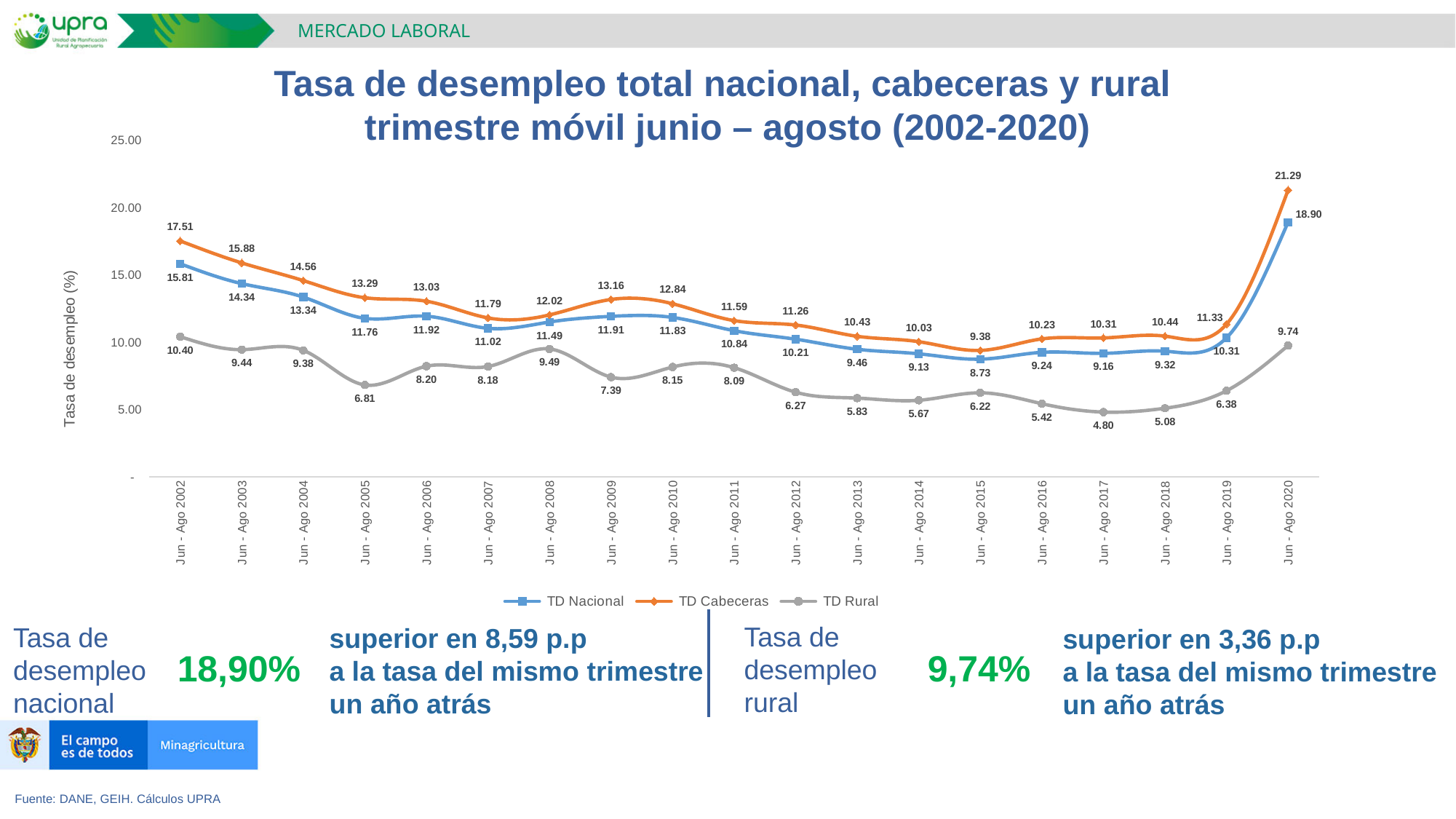
What is the value of TD Cabeceras for Jun - Ago 2020? 21.29 What is the value of TD Nacional for Jun - Ago 2002? 15.81 How many series does the legend list? 3 In which period does TD Nacional reach its lowest value? Jun - Ago 2015 In which period does TD Rural reach its highest value? Jun - Ago 2002 How many periods are shown on the x axis? 19 By how much did TD Rural increase from Jun - Ago 2019 to Jun - Ago 2020? 3.36 Which is larger for TD Rural: Jun - Ago 2008 or Jun - Ago 2009? Jun - Ago 2008 What is the difference between TD Cabeceras and TD Nacional in Jun - Ago 2020? 2.39 What kind of chart is shown on the slide? Line chart In which period does TD Cabeceras reach its lowest value? Jun - Ago 2015 What is the value of TD Rural for Jun - Ago 2017? 4.80